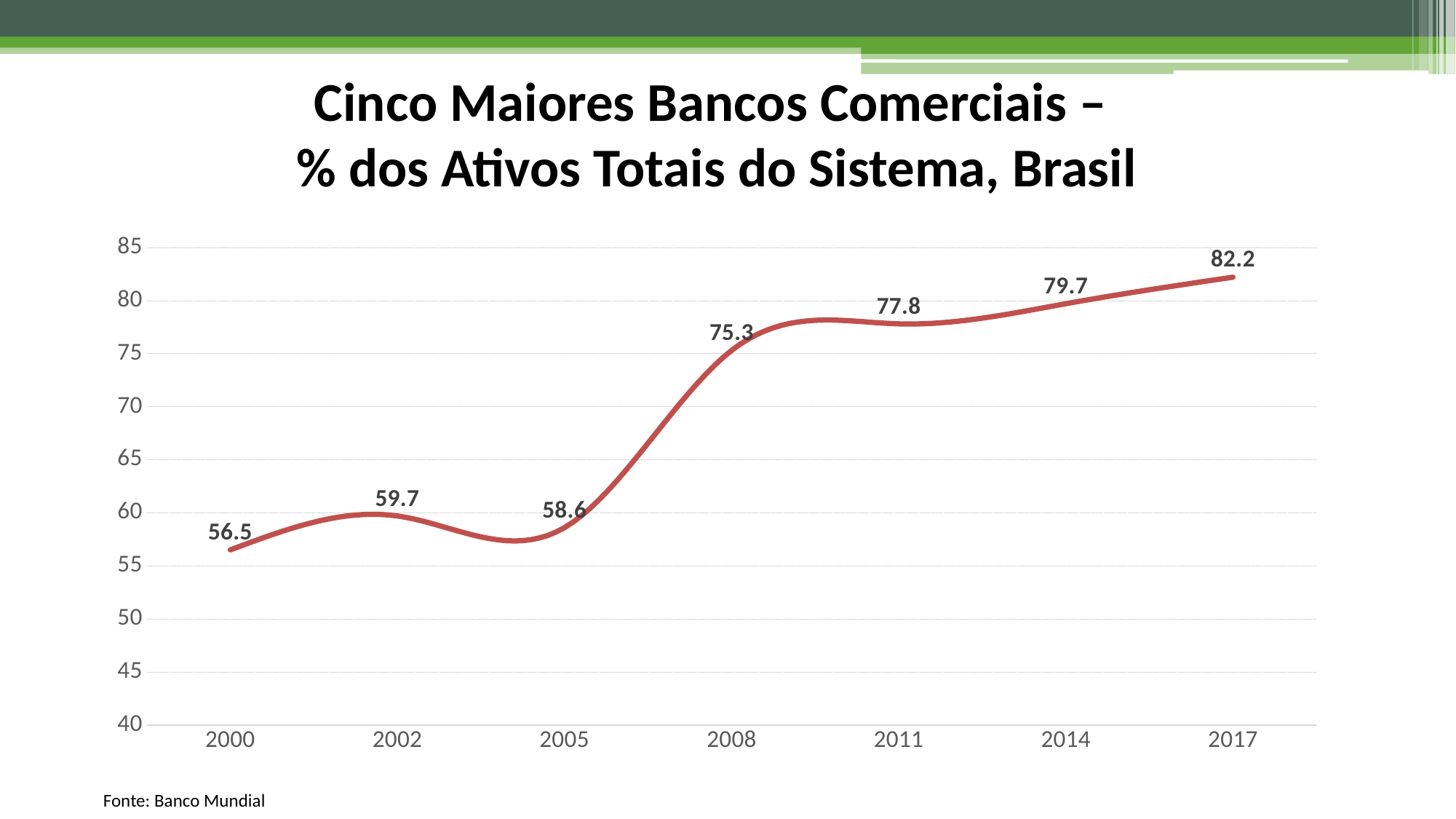
What is the value for 2017? 82.2 Which year has the highest value? 2017 What is the value for 2000? 56.5 Do the values generally rise or fall from 2000 to 2017? rise What kind of chart is shown on the slide? line chart What is the difference between the values for 2017 and 2000? 25.7 What is the value for 2008? 75.3 Which year has the lowest value? 2000 Is the value for 2011 greater or less than 70? greater How many data points are plotted on the chart? 7 Which is larger, the value for 2002 or the value for 2005? 2002 What is the difference between the values for 2008 and 2005? 16.7